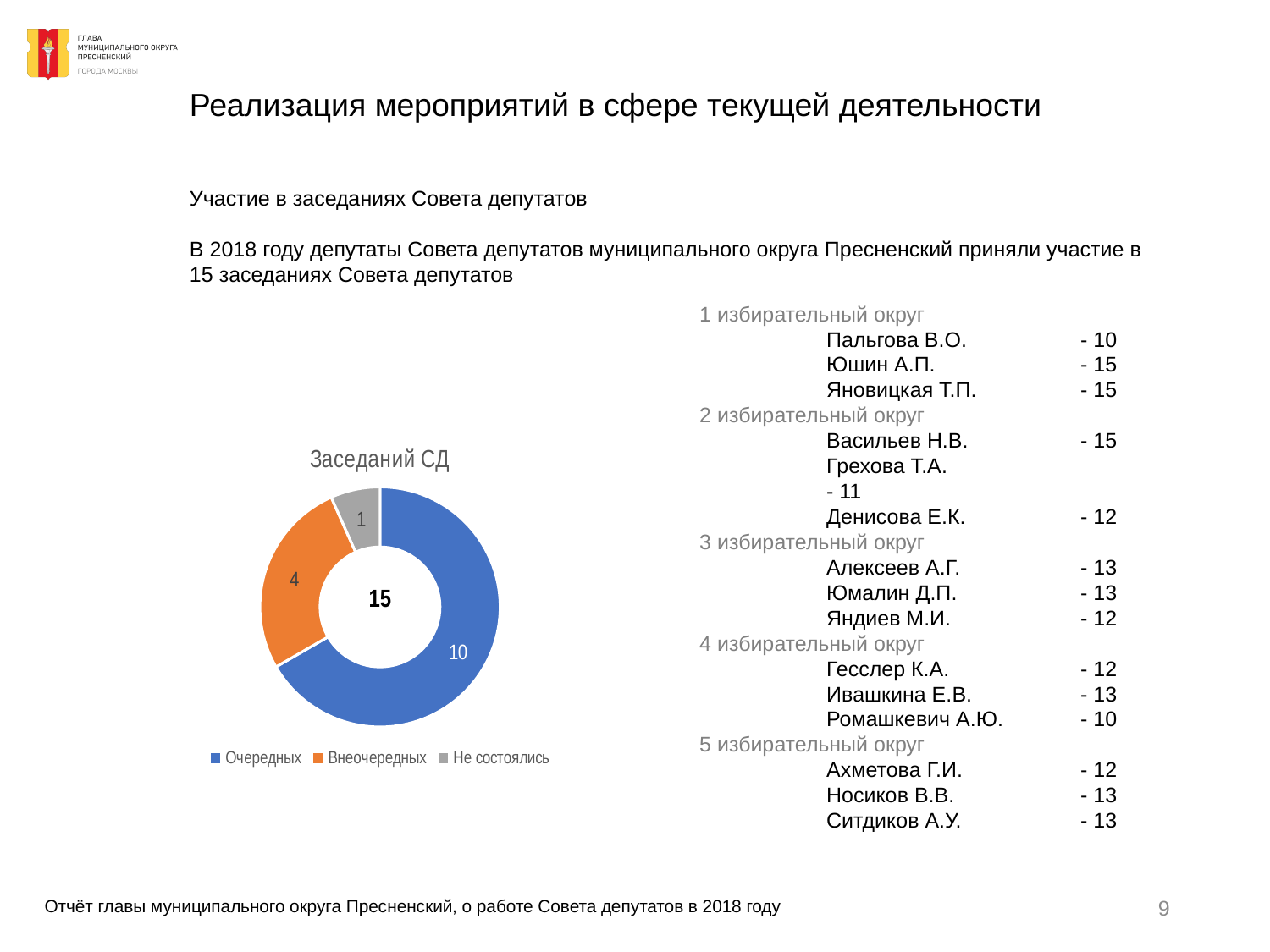
What is the value for Очередных in the chart? 10 What is the value for Внеочередных in the chart? 4 What is the title of the chart? Заседаний СД Which is larger, the value for Внеочередных or the value for Не состоялись? Внеочередных How many entries does the chart legend list? 3 Which category has the highest value in the chart? Очередных What kind of chart is shown on the slide? Doughnut chart What is the difference between the values for Очередных and Внеочередных? 6 How many categories does the chart show? 3 What is the value for Не состоялись in the chart? 1 Which category has the lowest value in the chart? Не состоялись What is the total of all the values in the chart? 15